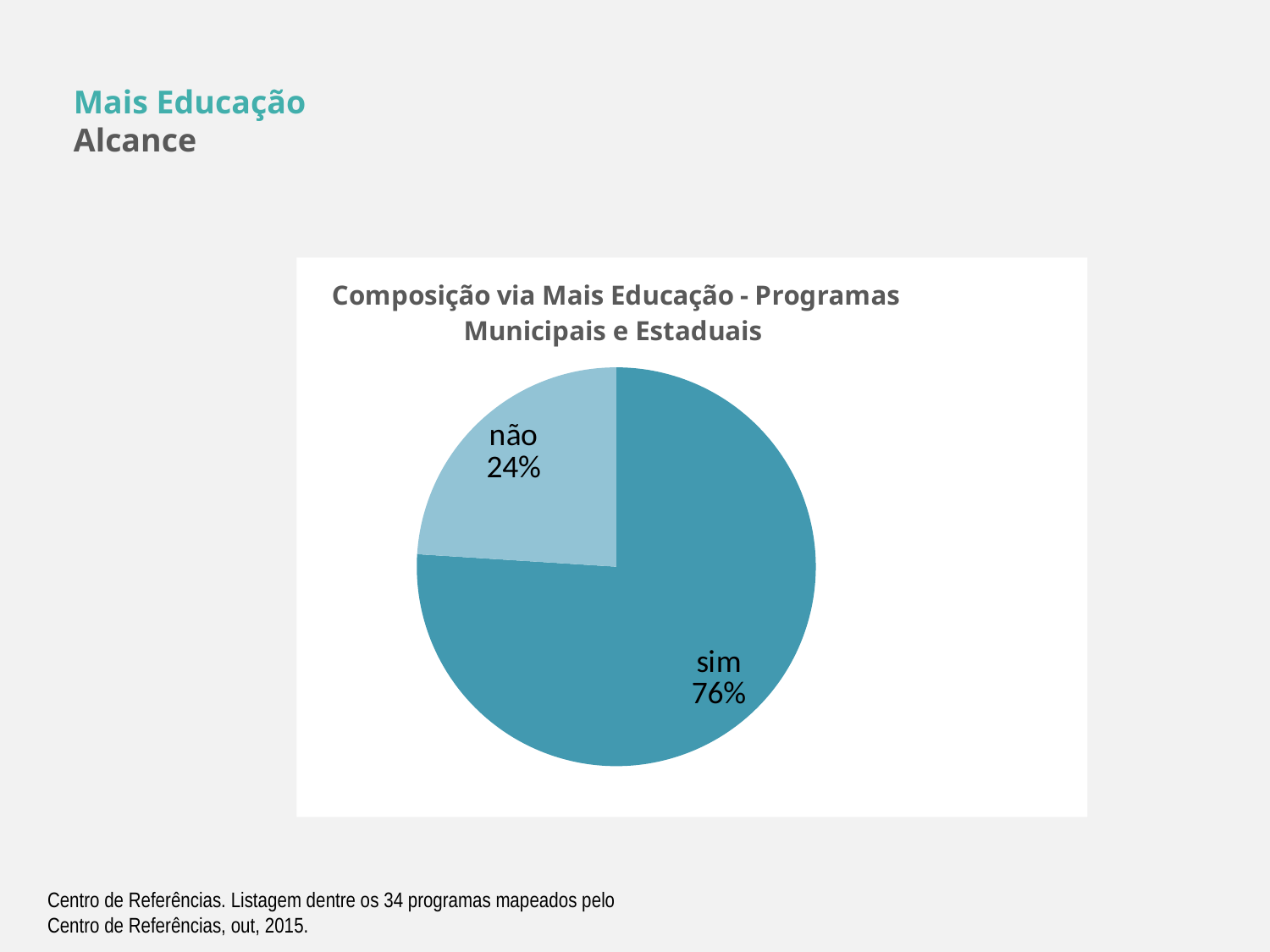
Which slice is shown in the lighter blue colour? não What share of the pie does the "não" slice represent? 24% Which is larger, the "sim" slice or the "não" slice? sim What is the title of the chart? Composição via Mais Educação - Programas Municipais e Estaduais What is the difference in percentage points between the "sim" and "não" slices? 52 What kind of chart is shown on the slide? pie chart What share of the pie does the "sim" slice represent? 76% Which slice is the largest in the pie chart? sim How many slices does the pie chart have? 2 Which slice is the smallest in the pie chart? não